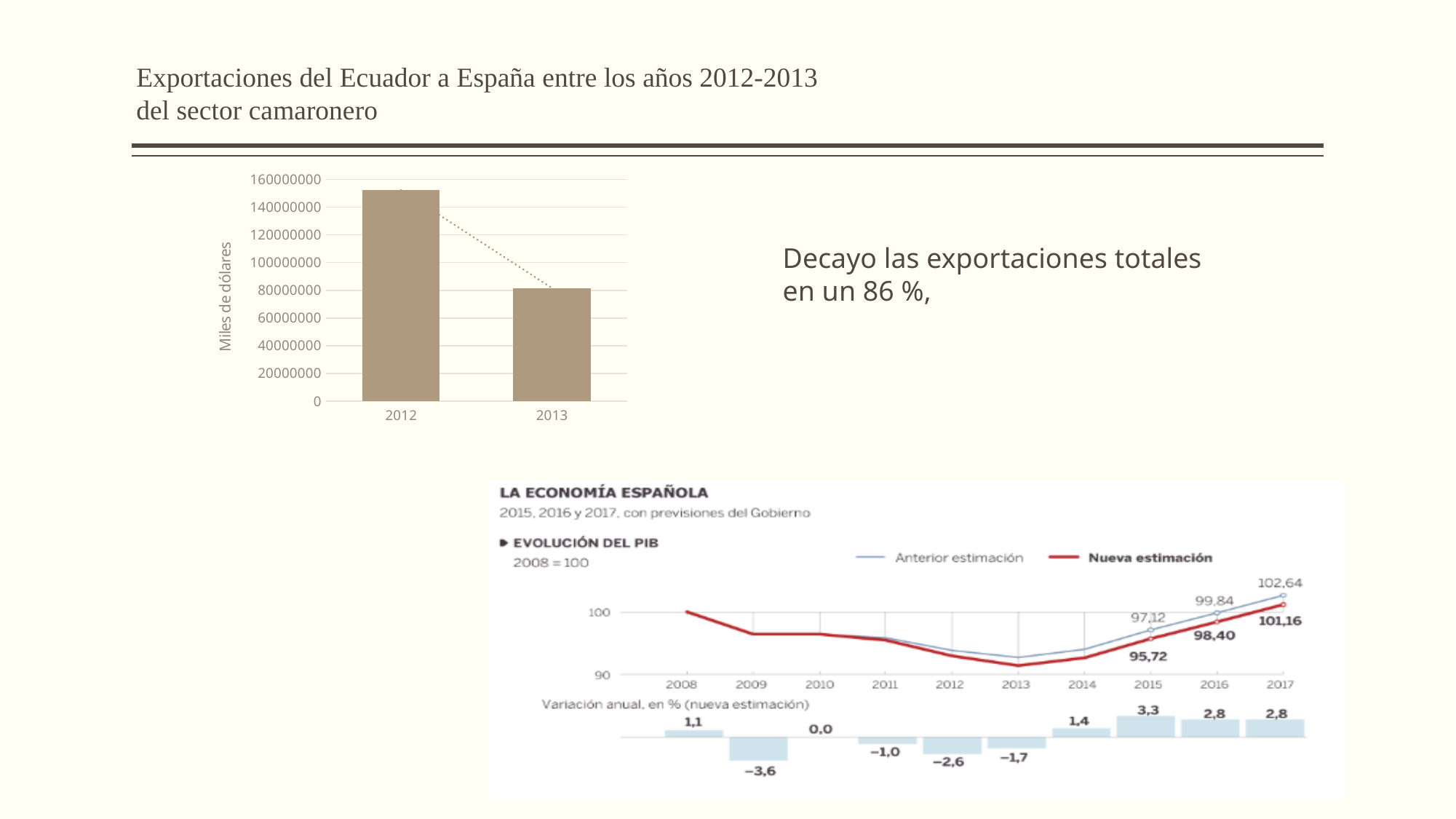
In the 'LA ECONOMÍA ESPAÑOLA' chart, what is the difference between the 'Anterior estimación' and 'Nueva estimación' values for 2016? 1,44 In the 'LA ECONOMÍA ESPAÑOLA' chart, what is the 'Nueva estimación' value for 2017 in the Evolución del PIB line chart? 101,16 In the top-left bar chart, is the value for 2012 greater or less than 140000000? greater In the top-left bar chart, how many categories are shown on the x axis? 2 In the 'LA ECONOMÍA ESPAÑOLA' chart, which year has the lowest annual variation in %? 2009 In the 'LA ECONOMÍA ESPAÑOLA' chart, what is the annual variation in % for 2009? -3,6 In the top-left bar chart, what is the label of the vertical axis? Miles de dólares In the top-left bar chart, is the value for 2013 greater or less than 100000000? less In the 'LA ECONOMÍA ESPAÑOLA' chart, which year has the highest annual variation in %? 2015 In the 'LA ECONOMÍA ESPAÑOLA' chart, what is the 'Anterior estimación' value for 2015 in the Evolución del PIB line chart? 97,12 In the 'LA ECONOMÍA ESPAÑOLA' chart, how many series does the legend of the Evolución del PIB line chart list? 2 In the top-left bar chart, which year has the higher value, 2012 or 2013? 2012